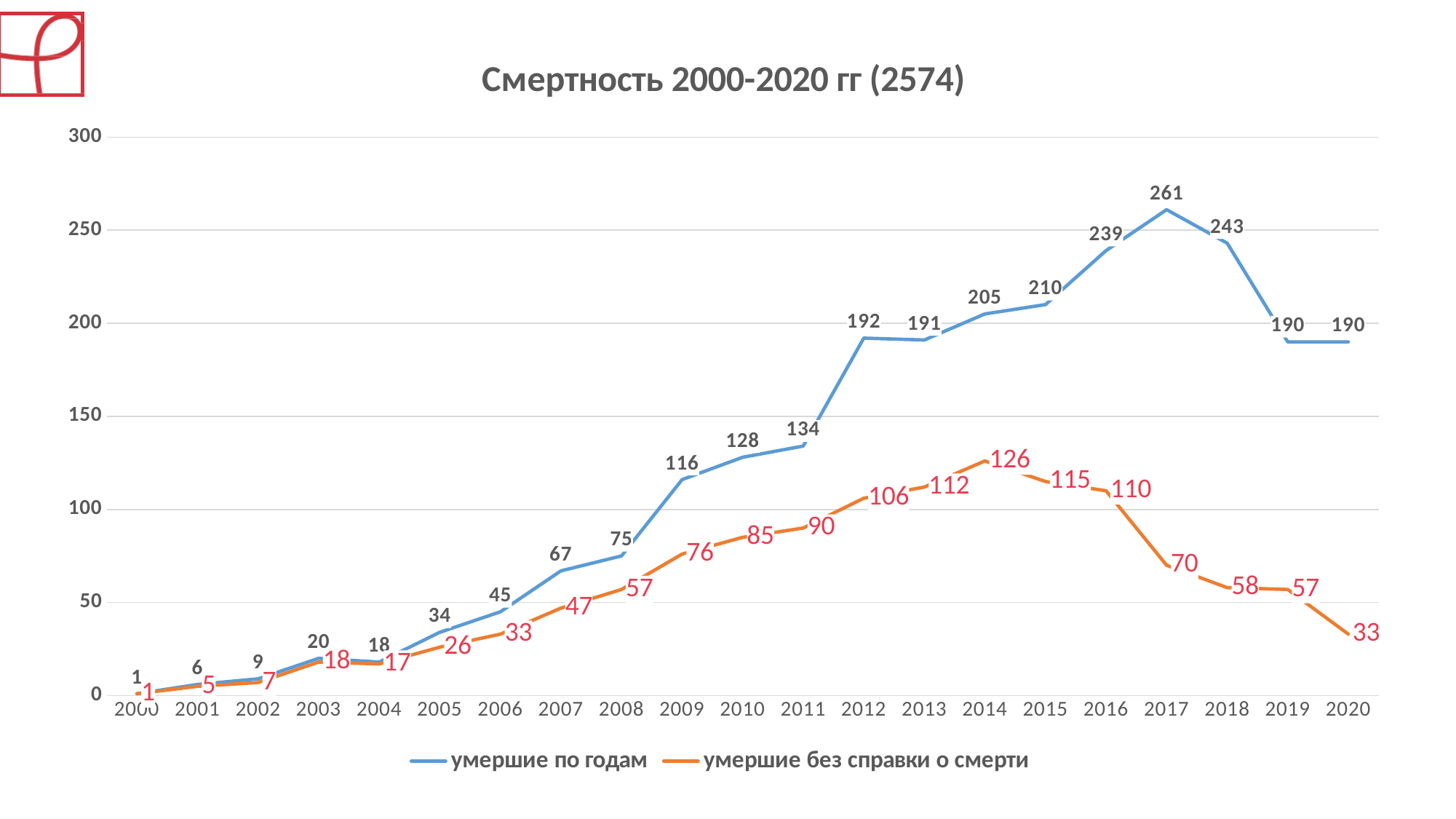
Does "умершие без справки о смерти" rise or fall from 2014 to 2020? fall Which is larger: "умершие по годам" in 2012 or in 2013? 2012 How many series does the legend list? 2 What is the value for "умершие по годам" in 2009? 116 What kind of chart is shown on the slide? line chart In which year does "умершие без справки о смерти" reach its lowest value? 2000 In which year does "умершие по годам" reach its highest value? 2017 How many years are shown on the x axis? 21 What is the difference between "умершие по годам" and "умершие без справки о смерти" in 2020? 157 What is the value for "умершие без справки о смерти" in 2014? 126 What is the value for "умершие по годам" in 2017? 261 What is the title of the chart? Смертность 2000-2020 гг (2574)